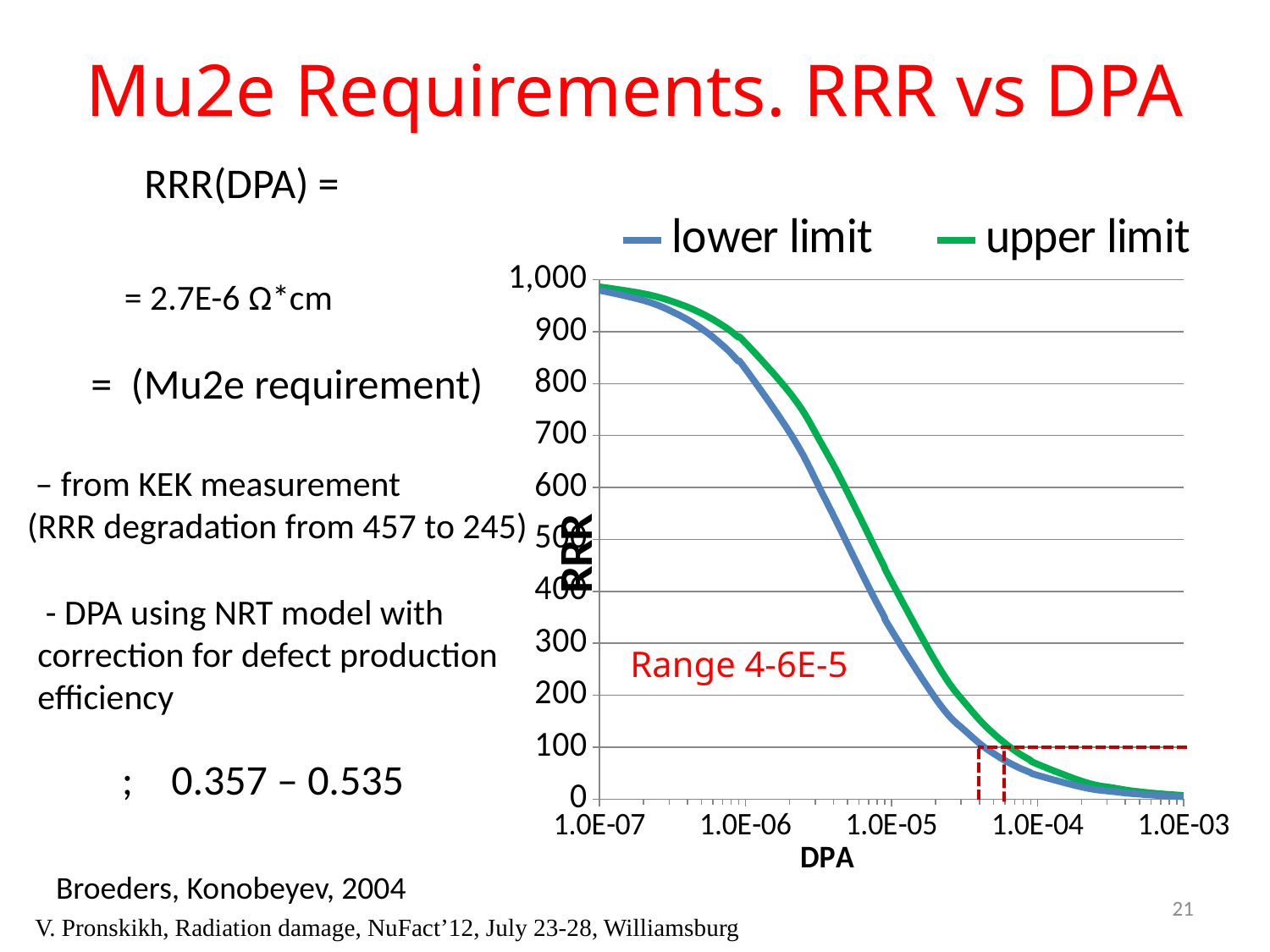
Is the lower limit value at DPA 1.0E-06 greater or less than 800? greater How many series does the chart legend list? 2 What kind of chart is shown on the slide? line chart Is the upper limit value at DPA 1.0E-04 greater or less than 100? less Do the RRR values rise or fall as DPA increases along the x axis? fall What are the two series named in the chart legend? lower limit, upper limit Is the lower limit value at DPA 1.0E-07 greater or less than 900? greater At DPA 1.0E-05, which series has the higher RRR value, lower limit or upper limit? upper limit What is the label of the x axis of the chart? DPA What is the highest value labelled on the RRR axis? 1,000 How many labelled tick values are shown on the DPA axis? 5